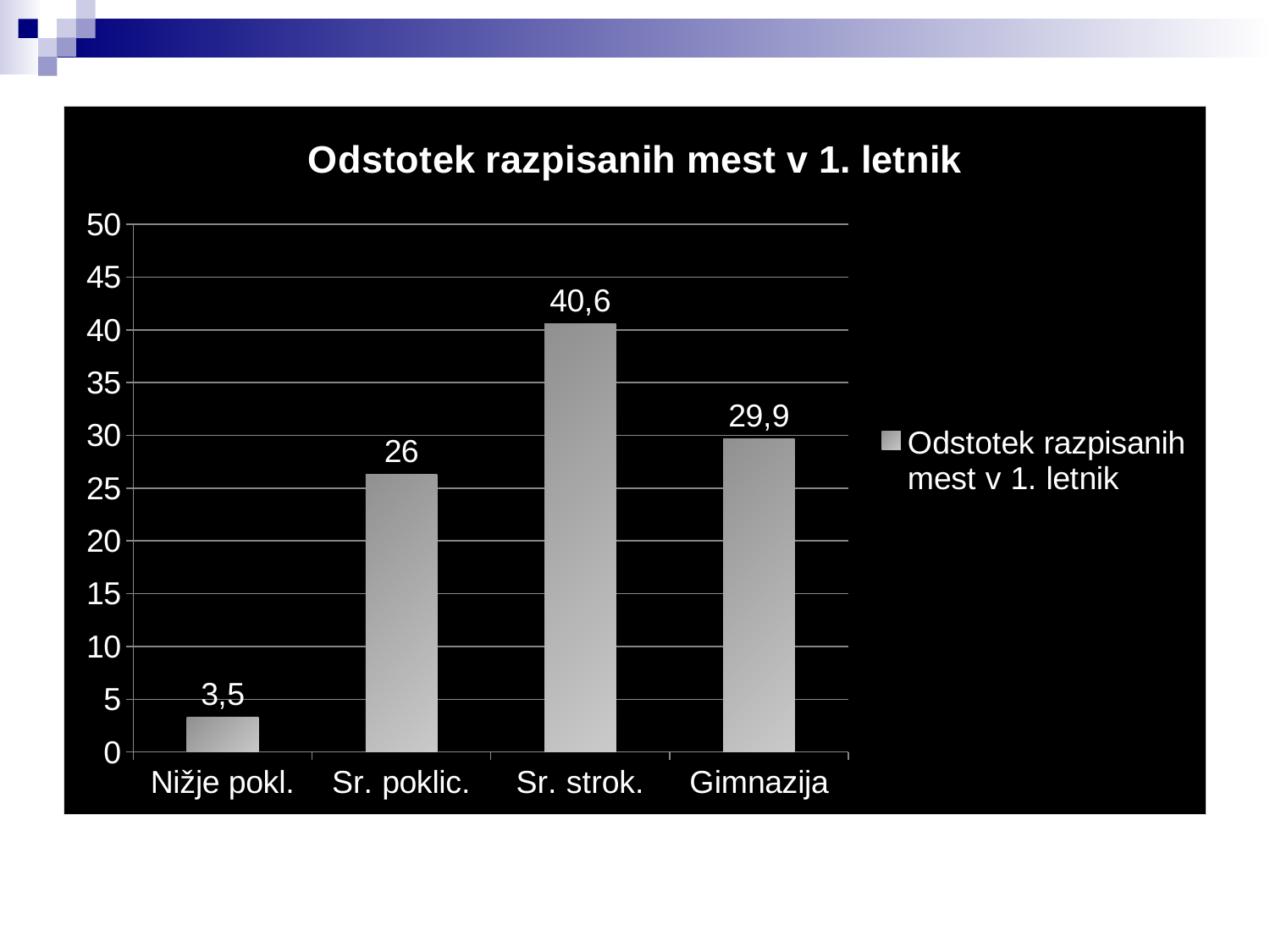
Which is larger, the value for Gimnazija or the value for Sr. poklic.? Gimnazija What is the value for Gimnazija? 29,9 What is the value for Sr. poklic.? 26 Is the value for Sr. poklic. greater or less than 30? less What is the difference between the values for Sr. strok. and Gimnazija? 10,7 Which category has the lowest value? Nižje pokl. How many categories are shown on the x axis? 4 Which category has the highest value? Sr. strok. What kind of chart is shown on the slide? bar chart What is the value for Sr. strok.? 40,6 What is the value for Nižje pokl.? 3,5 What is the title of the chart? Odstotek razpisanih mest v 1. letnik